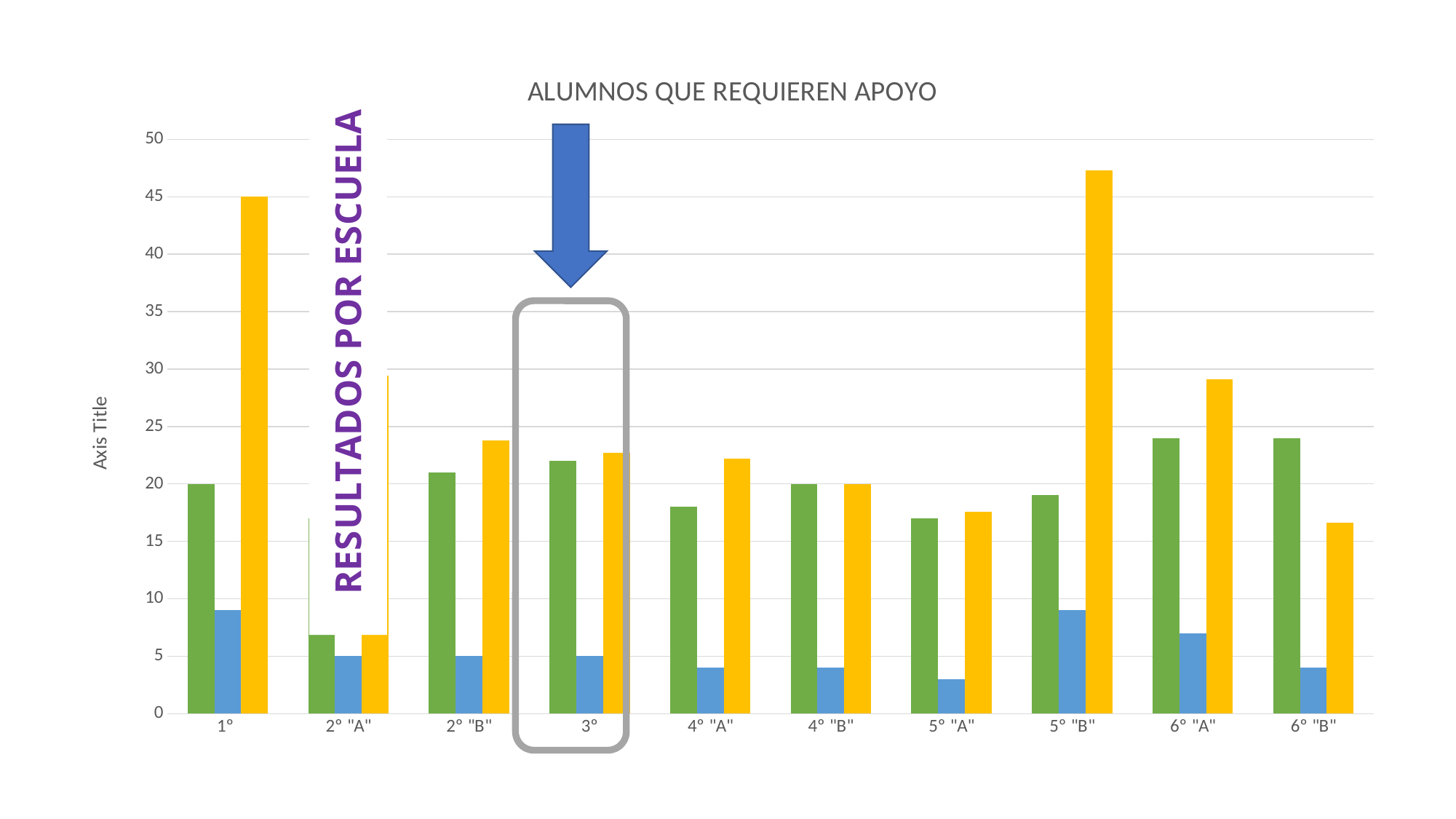
Which is larger, the green bar for 3° or the green bar for 5° "A"? 3° Is the blue bar for 5° "A" greater or less than 5? less What is the title of the chart? ALUMNOS QUE REQUIEREN APOYO Which is larger, the yellow bar for 1° or the yellow bar for 6° "A"? 1° Which category is highlighted with a rounded grey box and an arrow? 3° Is the yellow bar for 5° "B" greater or less than 45? greater How many categories are shown along the x axis? 10 What type of chart is shown on the slide? bar chart Is the yellow bar for 6° "A" greater or less than 25? greater Which category has the tallest yellow bar? 5° "B"